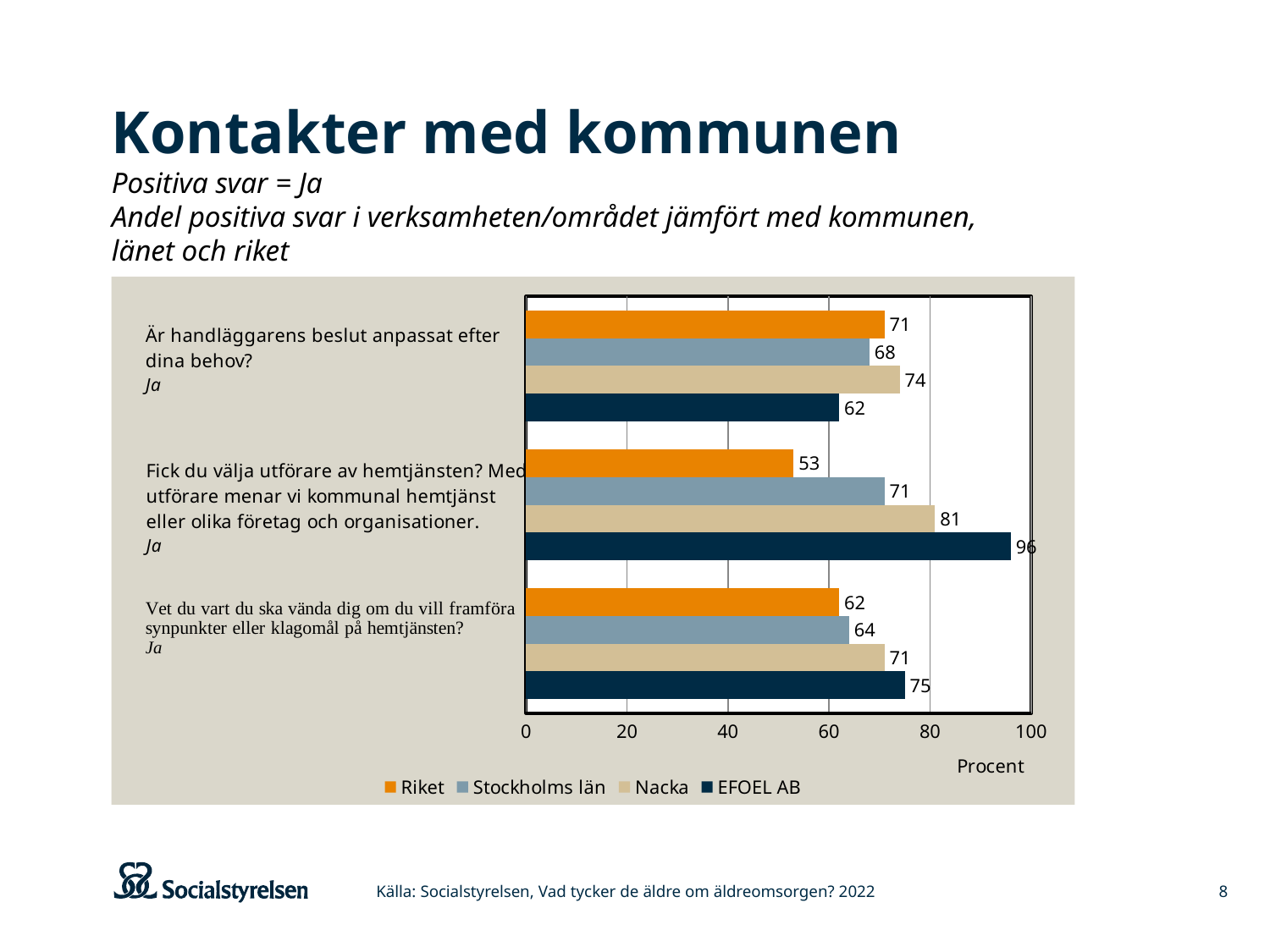
What unit is shown on the horizontal axis of the chart? Procent Which series has the lowest value on the question "Är handläggarens beslut anpassat efter dina behov?"? EFOEL AB What is the value for EFOEL AB on the question "Fick du välja utförare av hemtjänsten?"? 96 What is the value for Nacka on the question "Vet du vart du ska vända dig om du vill framföra synpunkter eller klagomål på hemtjänsten?"? 71 Which series has the highest value on the question "Fick du välja utförare av hemtjänsten?"? EFOEL AB What kind of chart is shown on the slide? Bar chart Is the value for Riket on the question "Fick du välja utförare av hemtjänsten?" greater or less than 60? less What is the value for Stockholms län on the question "Fick du välja utförare av hemtjänsten?"? 71 Which is larger on the question "Vet du vart du ska vända dig om du vill framföra synpunkter eller klagomål på hemtjänsten?": Nacka or Stockholms län? Nacka What is the difference between the EFOEL AB value and the Riket value on the question "Fick du välja utförare av hemtjänsten?"? 43 How many series does the legend list? 4 What is the value for Riket on the question "Är handläggarens beslut anpassat efter dina behov?"? 71